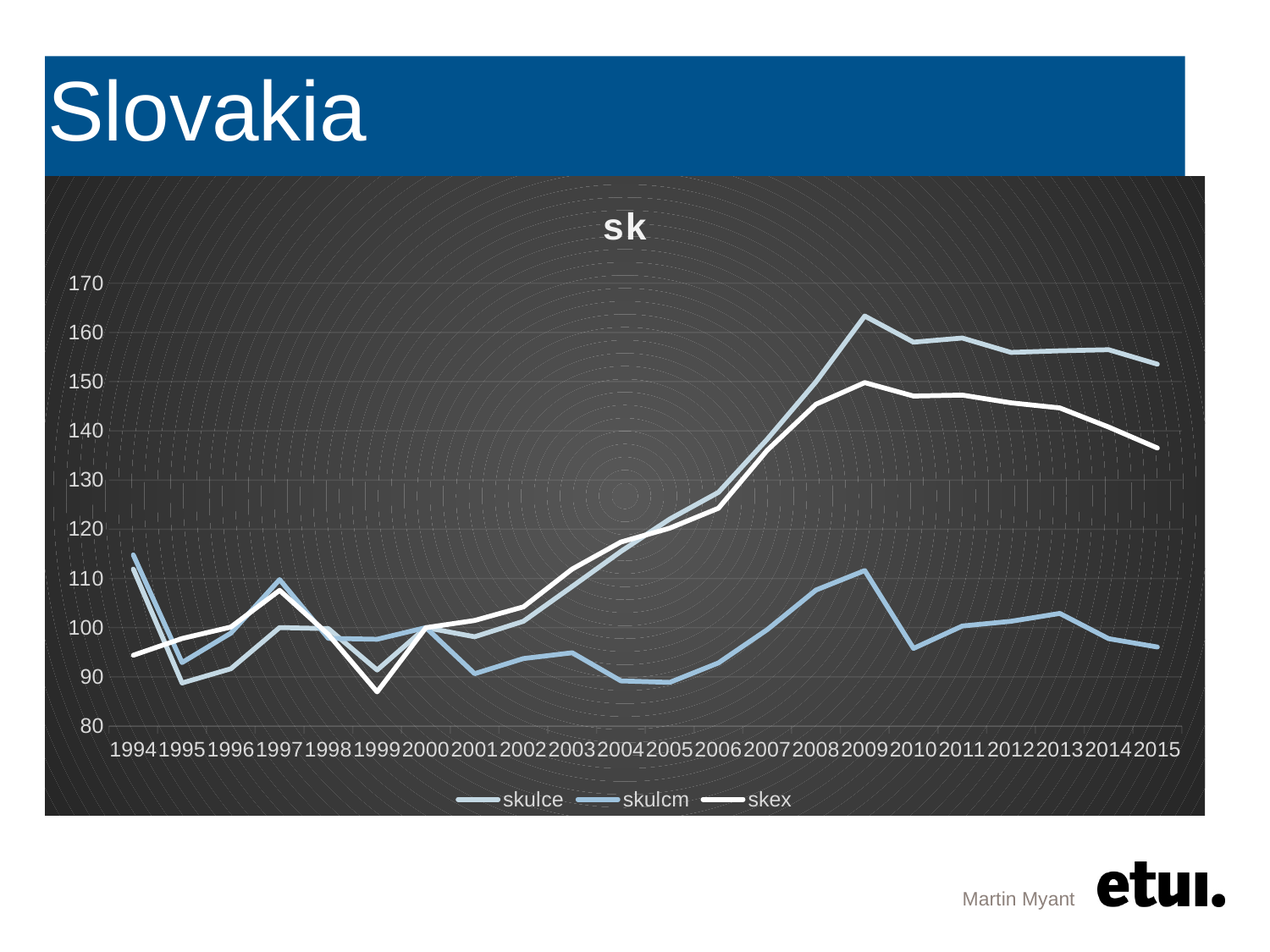
What kind of chart is shown on the slide? line chart What are the names of the series listed in the chart legend? skulce, skulcm, skex How many series does the legend of the chart list? 3 Does the skex series rise or fall between 2009 and 2015? fall In which year does the skex series reach its lowest value? 1999 Is the value for skex in 1999 greater or less than 90? less Is the value for skex in 2004 greater or less than 110? greater Is the value for skex in 2009 greater or less than 140? greater In which year does the skex series reach its highest value? 2009 What is the title of the chart? sk How many years are shown on the x axis of the chart? 22